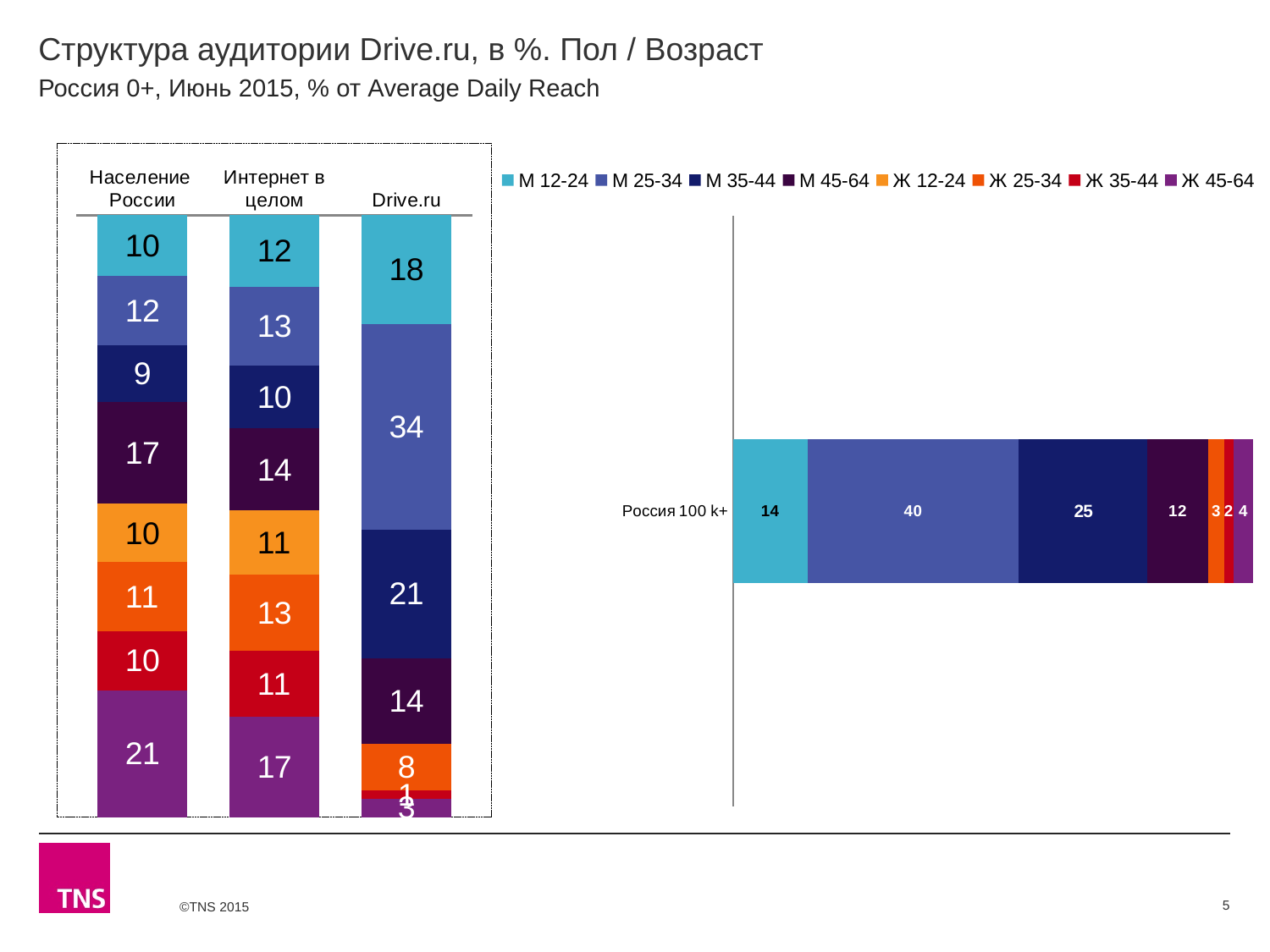
In the right chart (Россия 100 k+), what is the value of the М 25-34 segment? 40 In the left stacked bar chart, what is the value of the М 25-34 segment for Drive.ru? 34 In the left stacked bar chart, how much larger is the М 12-24 value for Drive.ru than for Население России? 8 How many bars (categories) are shown in the left stacked bar chart? 3 In the left stacked bar chart, what is the value of the Ж 45-64 segment for Население России? 21 In the left stacked bar chart, which series has the largest segment in the Drive.ru bar? М 25-34 What kind of chart is shown on the left of the slide? Stacked bar chart What is the category label of the single bar in the right chart? Россия 100 k+ How many series does the legend list? 8 In the right chart (Россия 100 k+), which series has the largest segment? М 25-34 In the left stacked bar chart, which has the larger Ж 45-64 value: Население России or Интернет в целом? Население России In the left stacked bar chart, what is the value of the М 45-64 segment for Интернет в целом? 14